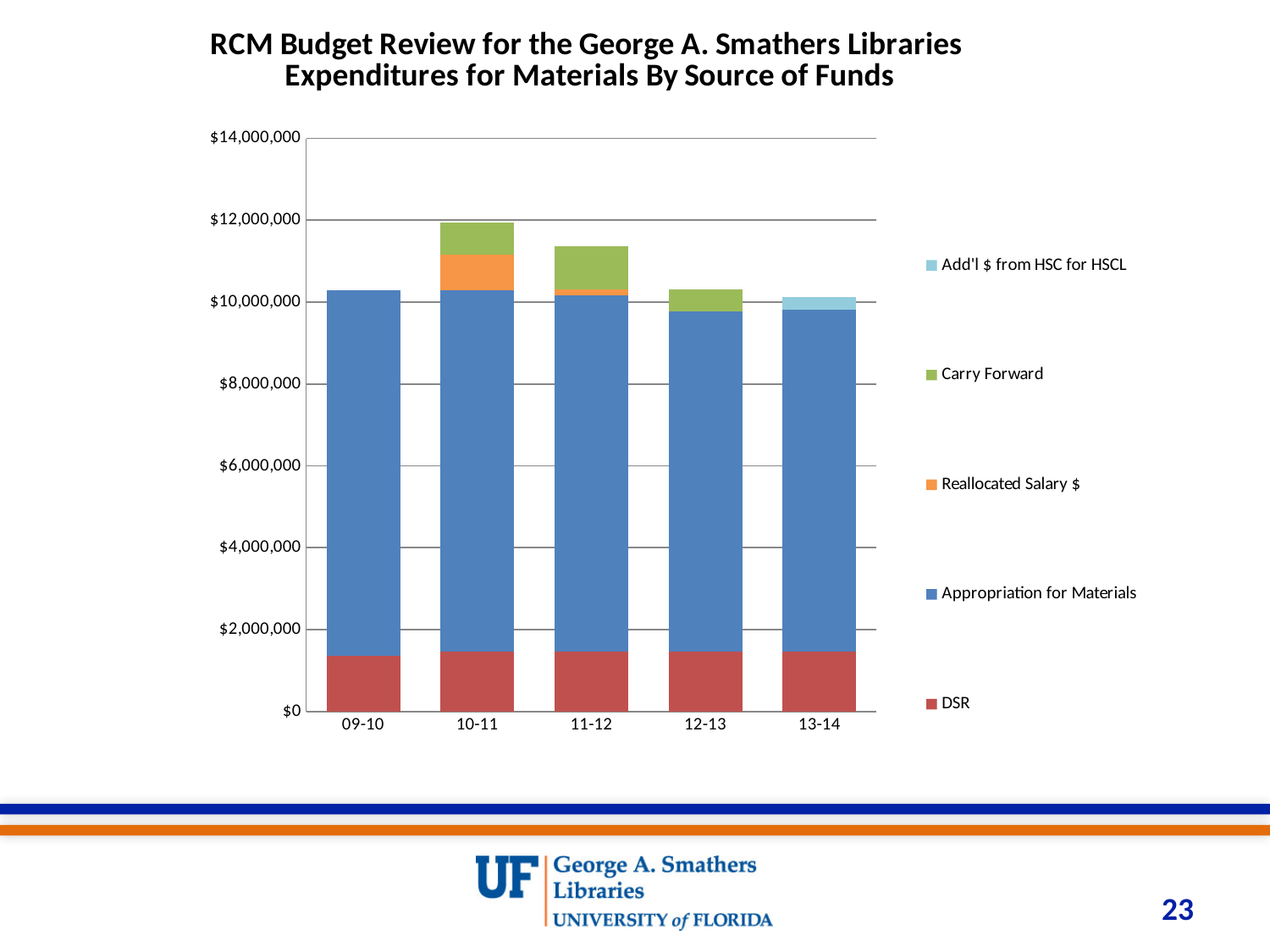
Which fiscal year has the tallest total bar? 10-11 How many fiscal years are shown on the x axis? 5 What kind of chart is shown on the slide? Stacked bar chart Which total bar is taller, 11-12 or 13-14? 11-12 Which total bar is taller, 10-11 or 12-13? 10-11 Is the DSR segment for 09-10 greater or less than $2,000,000? less Which series is shown at the bottom of each stacked bar? DSR Is the total bar for 10-11 greater or less than $12,000,000? less How many series does the legend list? 5 Is the total bar for 09-10 greater or less than $10,000,000? greater Which fiscal year is the only one with an "Add'l $ from HSC for HSCL" segment? 13-14